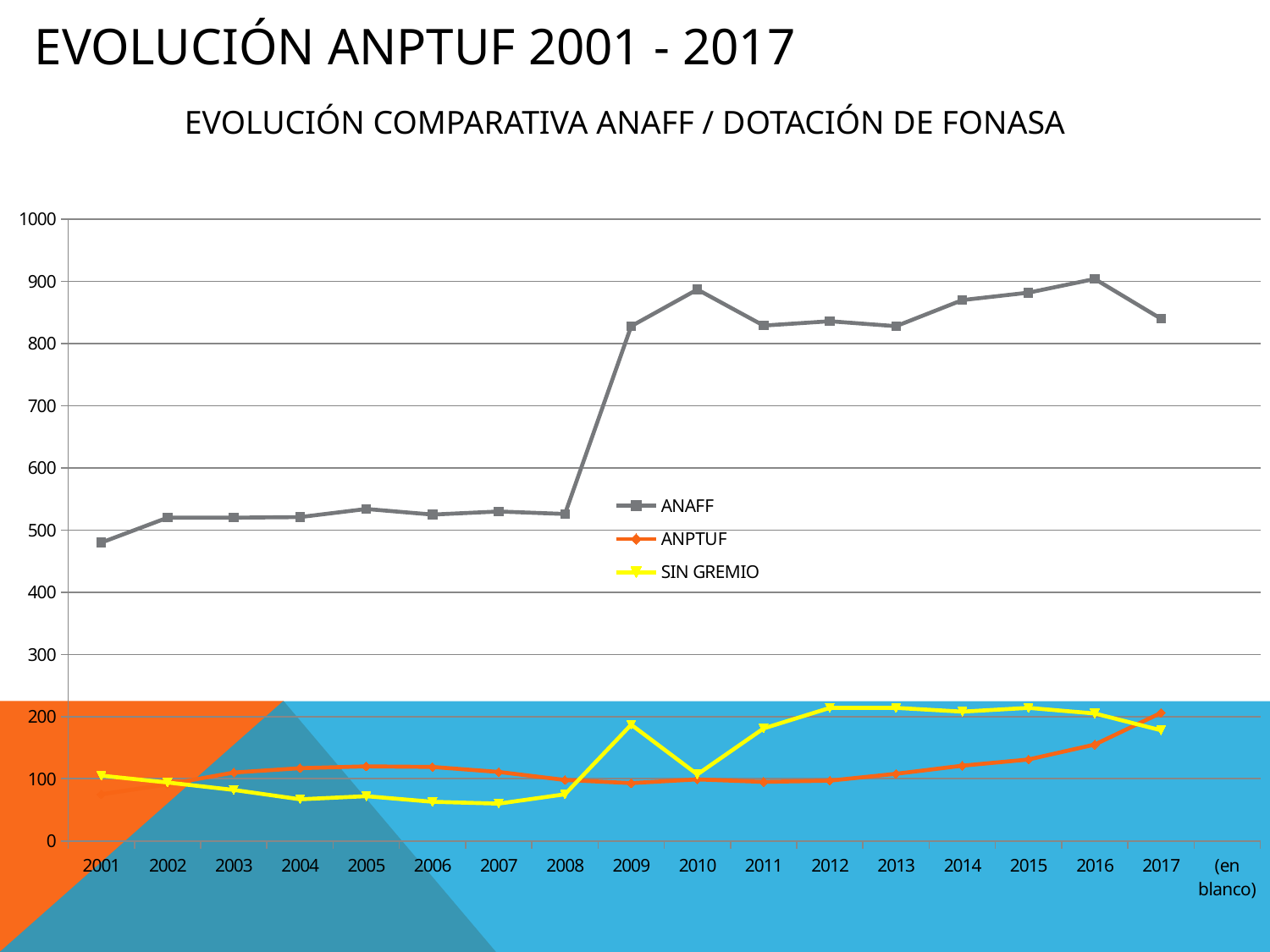
Is the value for ANAFF in 2001 greater or less than 400? greater Does the ANAFF series rise or fall from 2008 to 2009? rise What is the title printed above the chart? EVOLUCIÓN COMPARATIVA ANAFF / DOTACIÓN DE FONASA In 2004, which is larger: ANPTUF or SIN GREMIO? ANPTUF How many series does the legend list? 3 Is the value for SIN GREMIO in 2010 greater or less than 200? less In which year is the ANPTUF series at its highest? 2017 What are the three series named in the legend? ANAFF, ANPTUF, SIN GREMIO In which year is the ANAFF series at its lowest? 2001 What kind of chart is shown on the slide? line chart In 2009, which is larger: SIN GREMIO or ANPTUF? SIN GREMIO Is the value for ANAFF in 2009 greater or less than 800? greater